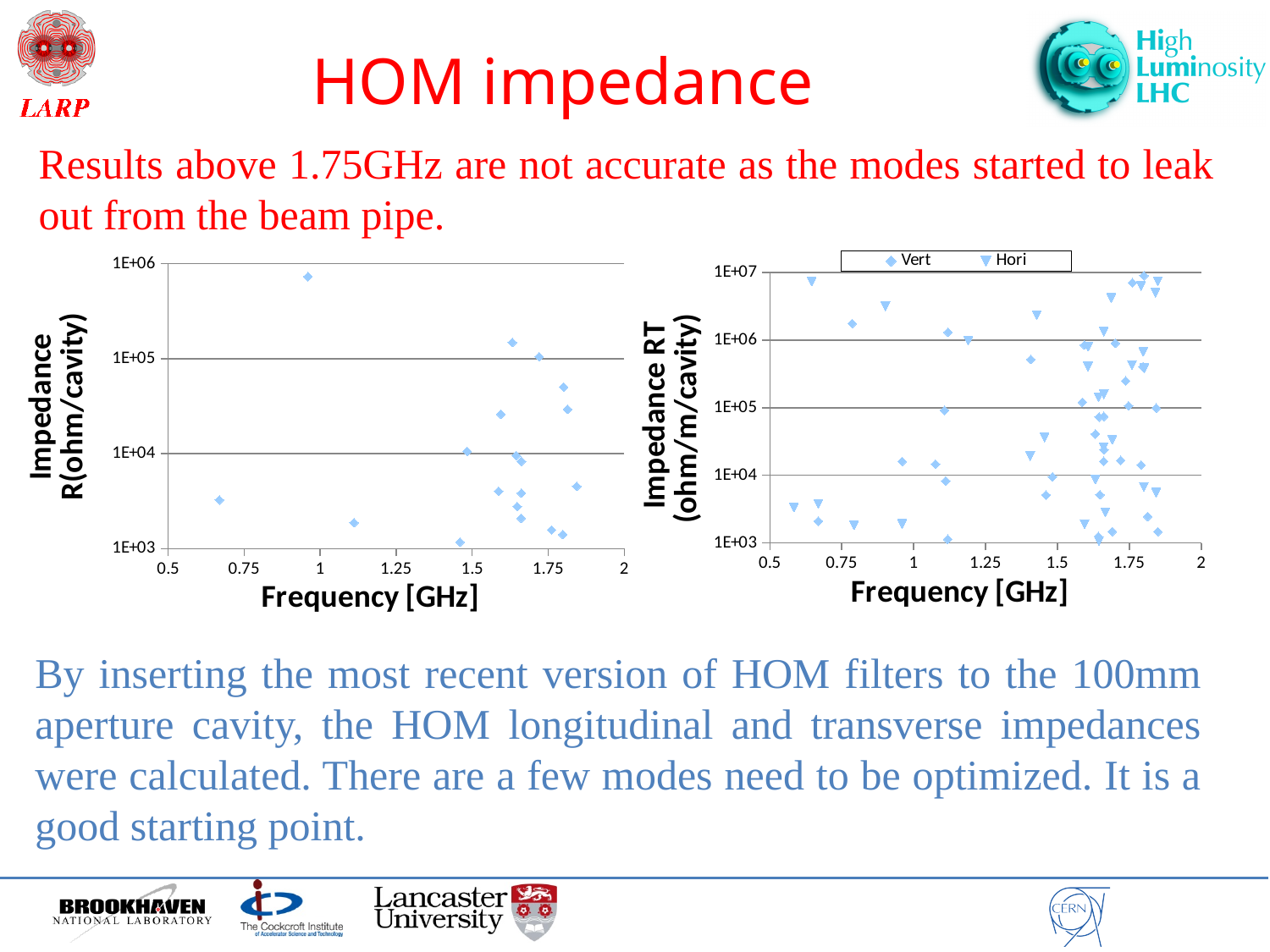
In the left chart (Impedance R), which has the higher impedance: the point near 0.96 GHz or the point near 0.67 GHz? the point near 0.96 GHz What kind of chart is the left chart (Impedance R(ohm/cavity) vs Frequency)? scatter chart What are the legend entries of the right chart (Impedance RT)? Vert and Hori How many series does the legend of the right chart (Impedance RT) list? 2 In the left chart (Impedance R), is the point near 1.1 GHz greater or less than 1E+04? less What is the y-axis title of the left chart? Impedance R(ohm/cavity) In the left chart (Impedance R), is the highest point, located near 0.96 GHz, greater or less than 1E+05? greater In the right chart (Impedance RT), is the Hori point near 0.65 GHz greater or less than 1E+06? greater